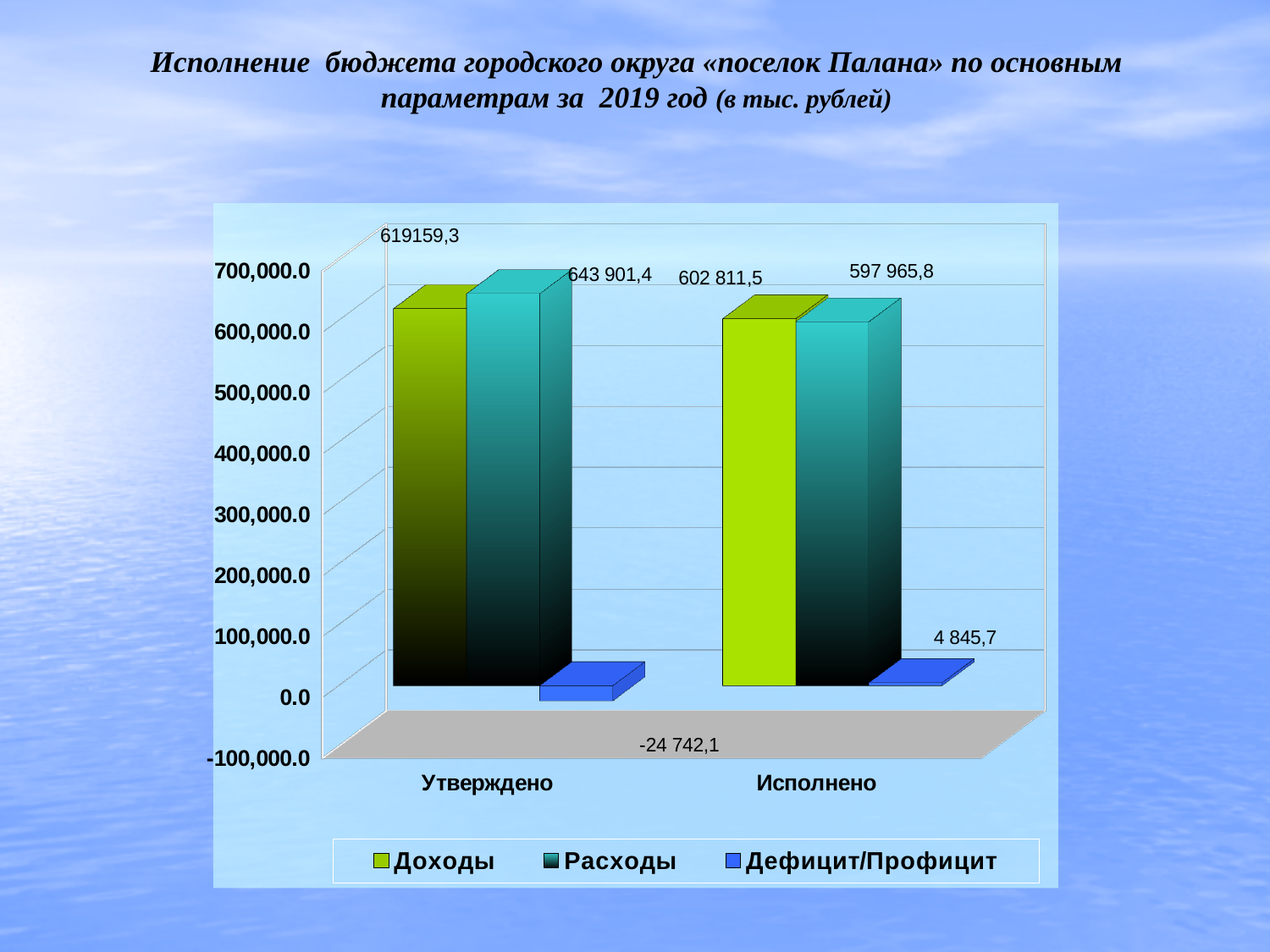
What is the value of Расходы for Исполнено? 597 965,8 What kind of chart is shown on the slide? Bar chart What is the value of Доходы for Утверждено? 619159,3 What is the difference between Доходы for Утверждено and Доходы for Исполнено? 16 347,8 What is the value of Расходы for Утверждено? 643 901,4 How many series does the legend list? 3 What is the value of Дефицит/Профицит for Исполнено? 4 845,7 Which is larger for Исполнено: Доходы or Расходы? Доходы What is the value of Дефицит/Профицит for Утверждено? -24 742,1 Which is larger for Утверждено: Доходы or Расходы? Расходы What is the difference between Расходы and Доходы for Утверждено? 24 742,1 What is the value of Доходы for Исполнено? 602 811,5